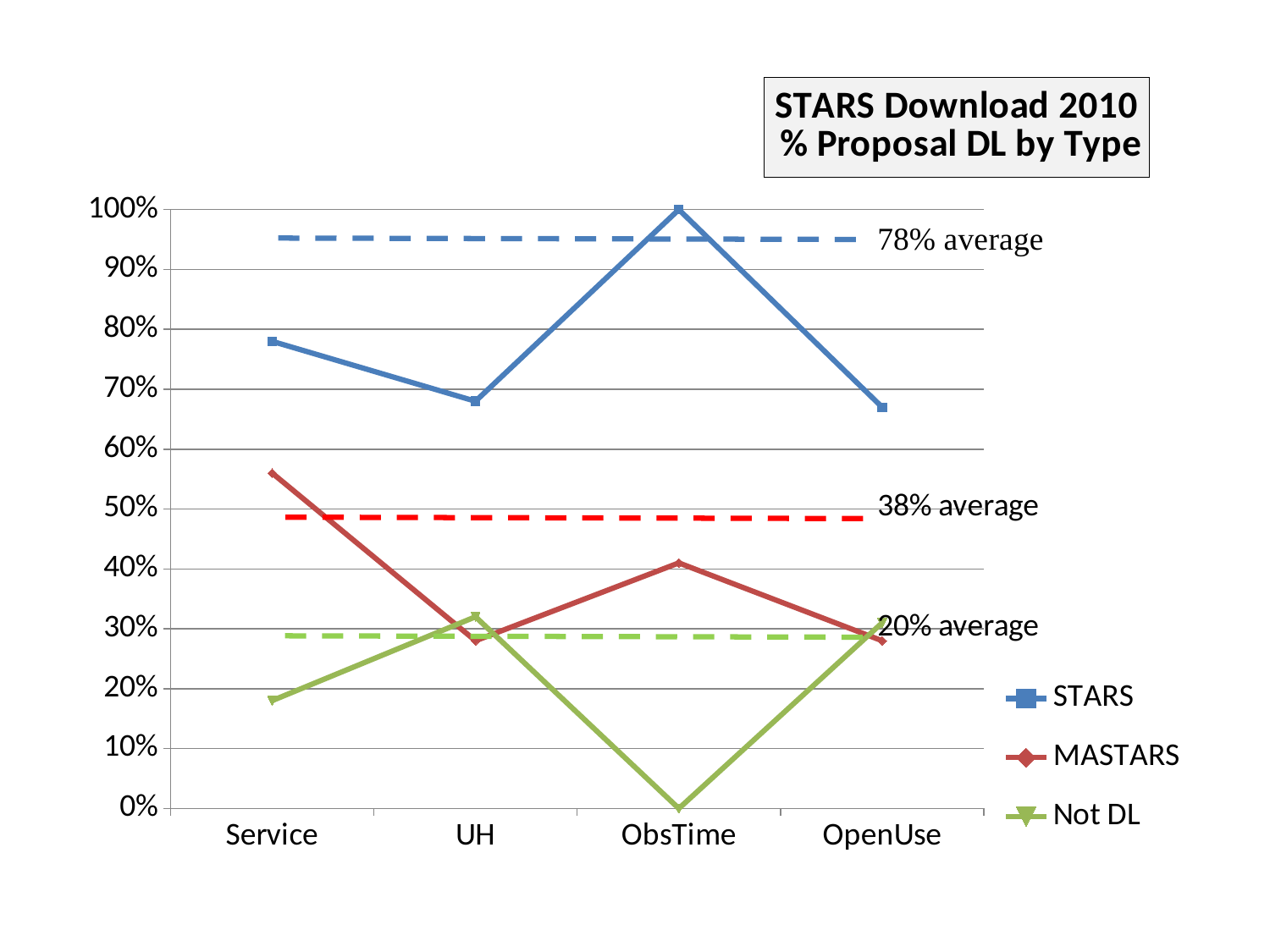
What average is annotated for the STARS series? 78% average What is the title of the chart? STARS Download 2010 % Proposal DL by Type For which category is the Not DL series lowest? ObsTime Is the MASTARS value for Service greater or less than 50%? greater Which is larger at Service, the STARS value or the MASTARS value? STARS How many series does the legend list? 3 What is the STARS value for ObsTime? 100% What type of chart is shown on the slide? line chart How many categories are shown on the x axis? 4 What is the Not DL value for ObsTime? 0% Is the Not DL value for Service greater or less than 30%? less For which category is the STARS series highest? ObsTime